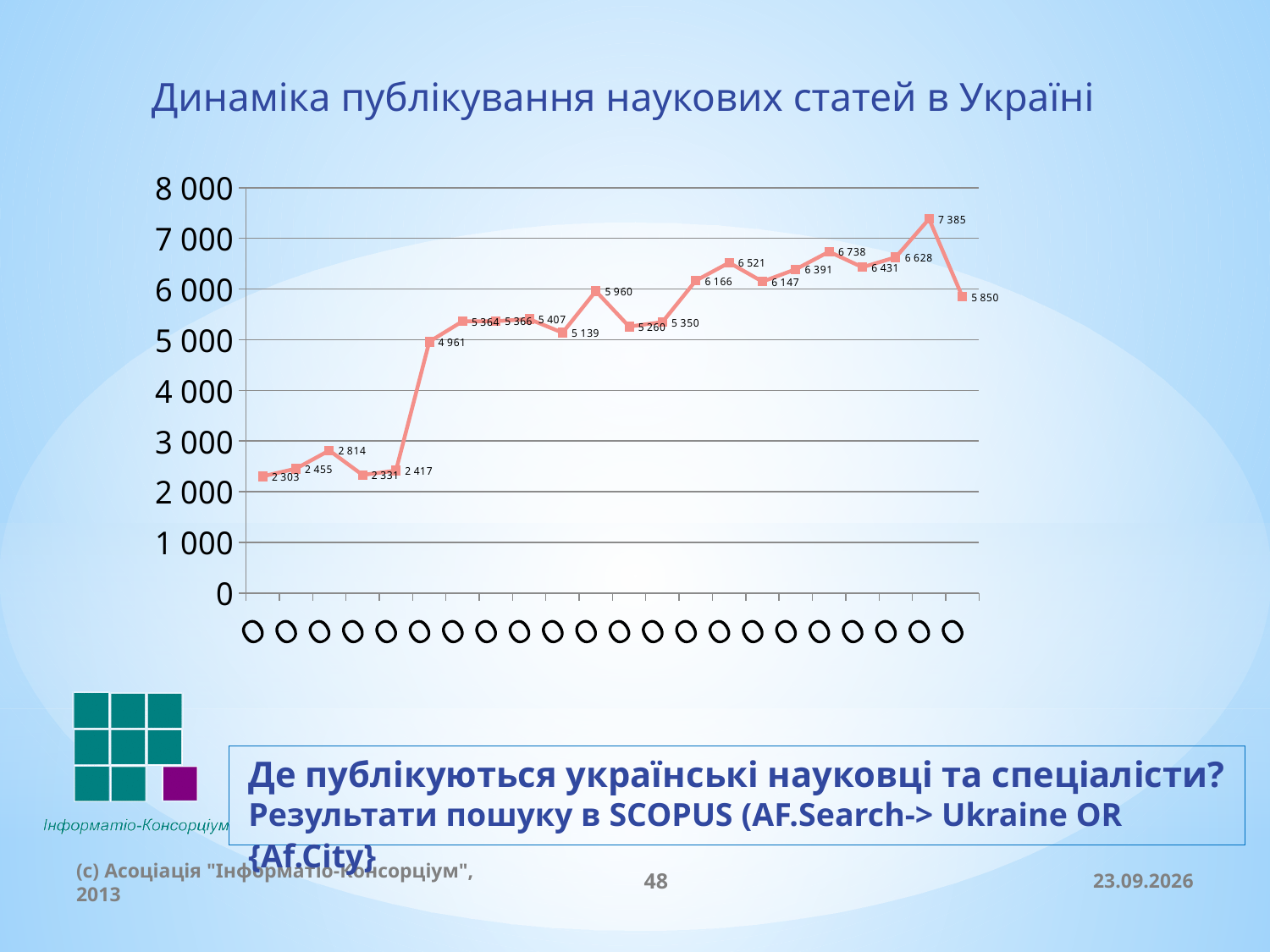
What is the difference between the highest and lowest values on the chart? 5 082 How many data points are plotted on the line? 22 What kind of chart is shown on the slide? line chart Is the value of the sixth data point (4 961) greater or less than 4 000? greater What is the value of the last data point on the line? 5 850 What is the lowest value plotted on the chart? 2 303 Which is larger, the value of the first data point or the value of the last data point? the last data point (5 850) What is the value of the first data point on the line? 2 303 What is the highest value plotted on the chart? 7 385 What is the value of the third data point on the line? 2 814 What is the title of the chart? Динаміка публікування наукових статей в Україні Do the values generally rise or fall from left to right along the x axis? rise